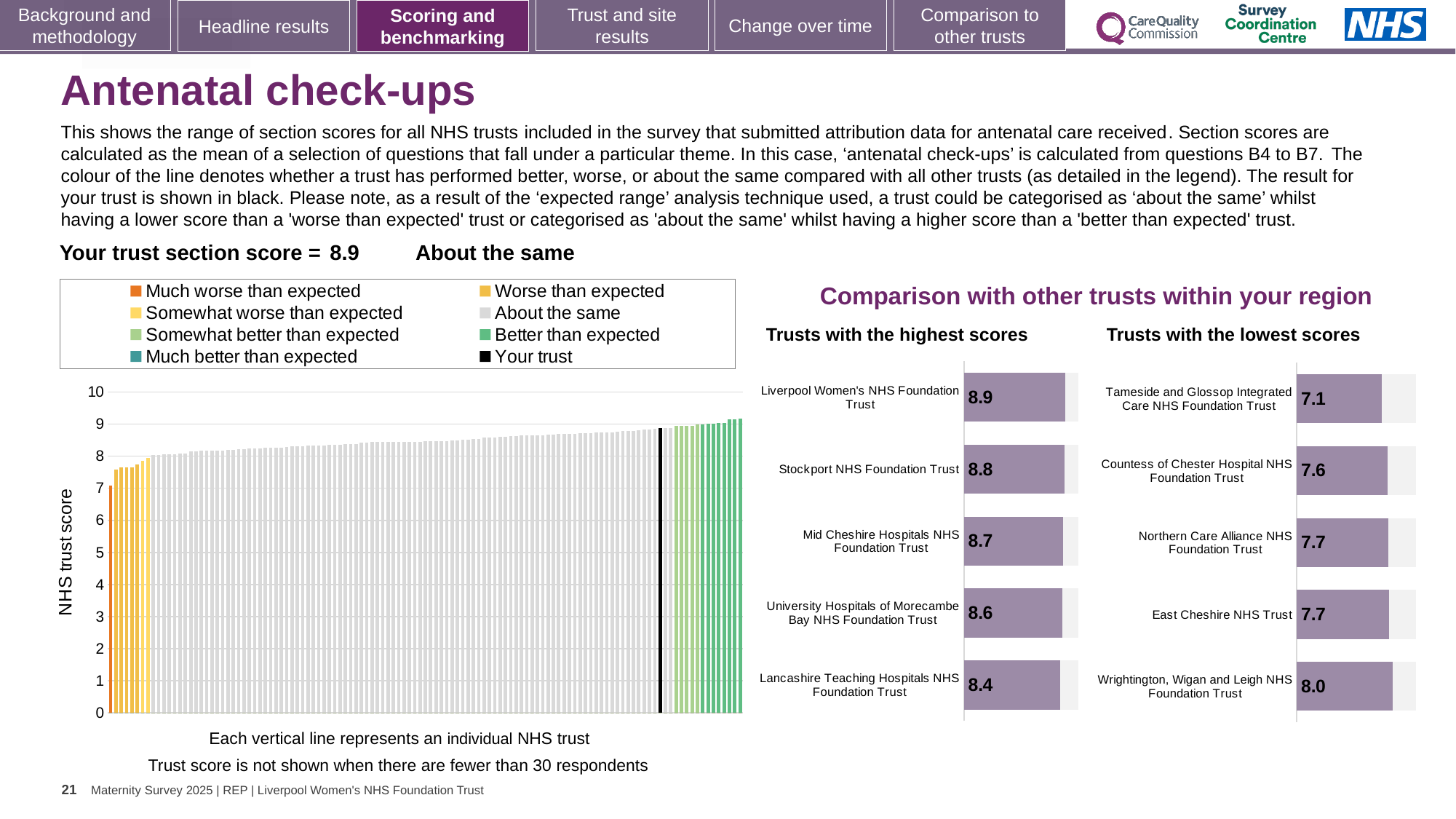
In the 'Trusts with the highest scores' chart, which has the larger score: Mid Cheshire Hospitals NHS Foundation Trust or Lancashire Teaching Hospitals NHS Foundation Trust? Mid Cheshire Hospitals NHS Foundation Trust How many entries does the legend of the NHS trust score chart on the left list? 8 In the 'Trusts with the highest scores' chart, what is the score for Stockport NHS Foundation Trust? 8.8 In the 'Trusts with the lowest scores' chart, what is the score for Countess of Chester Hospital NHS Foundation Trust? 7.6 In the 'Trusts with the highest scores' chart, what is the difference between the scores of Liverpool Women's NHS Foundation Trust and Lancashire Teaching Hospitals NHS Foundation Trust? 0.5 In the NHS trust score chart on the left, is the value of the leftmost (orange) bar greater or less than 8? less In the 'Trusts with the lowest scores' chart, how many trusts are shown? 5 In the 'Trusts with the lowest scores' chart, what is the difference between the scores of Wrightington, Wigan and Leigh NHS Foundation Trust and Tameside and Glossop Integrated Care NHS Foundation Trust? 0.9 In the 'Trusts with the highest scores' chart, which trust has the highest score? Liverpool Women's NHS Foundation Trust In the NHS trust score chart on the left, do the bar values rise or fall from left to right? Rise In the 'Trusts with the lowest scores' chart, which trust has the lowest score? Tameside and Glossop Integrated Care NHS Foundation Trust What kind of chart is the NHS trust score chart on the left of the slide? Bar chart